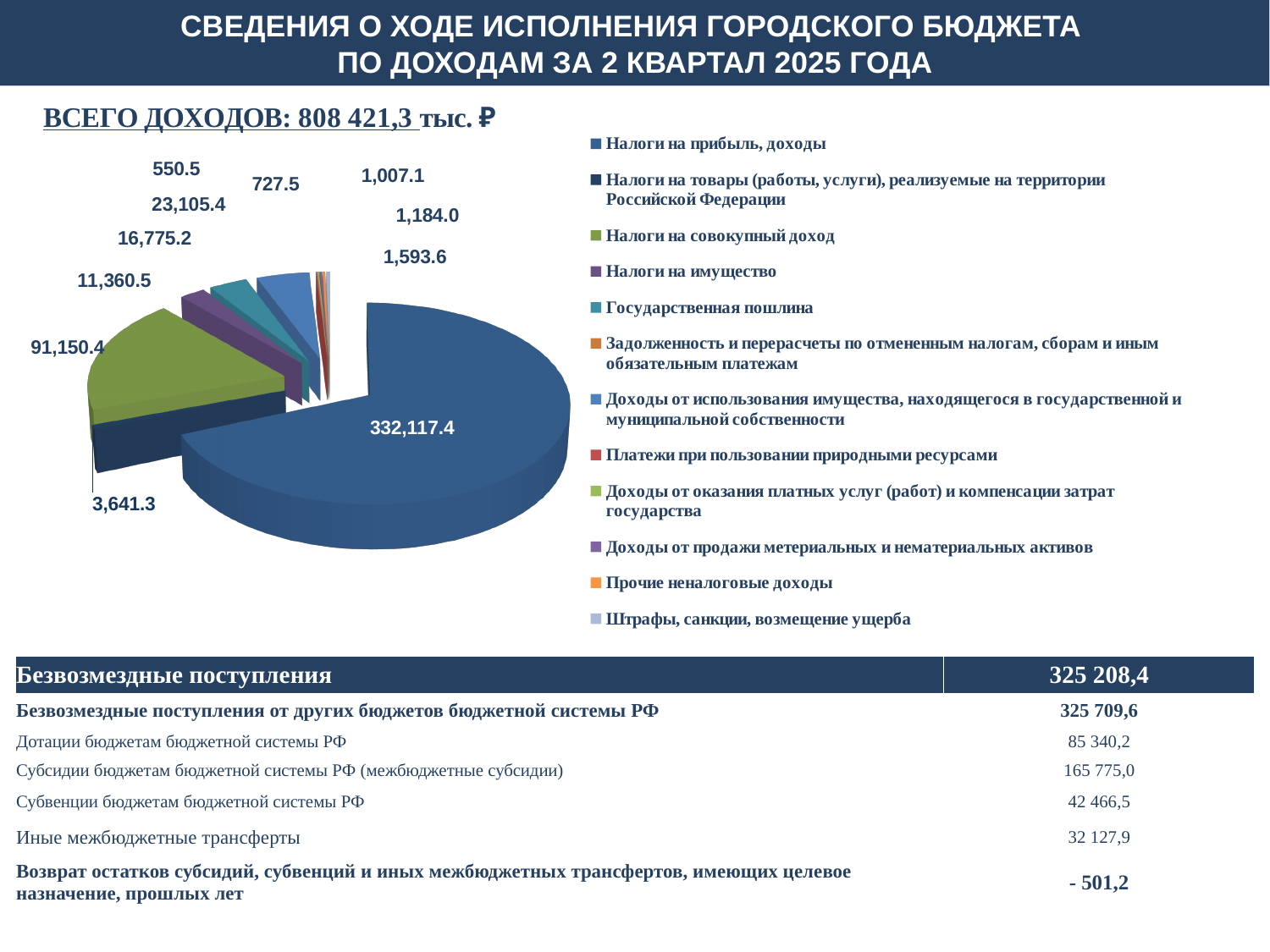
What is the value shown for Доходы от использования имущества, находящегося в государственной и муниципальной собственности? 23,105.4 What is the difference between the values for Налоги на прибыль, доходы and Налоги на совокупный доход? 240,967.0 What is the smallest data label value shown on the pie chart? 550.5 Which is larger: Государственная пошлина or Налоги на имущество? Государственная пошлина What kind of chart is shown on the slide? Pie chart How many entries does the legend of the pie chart list? 12 What is the value shown for Государственная пошлина? 16,775.2 What is the value of the largest slice in the pie chart? 332,117.4 What is the value shown for Налоги на совокупный доход? 91,150.4 What is the value shown for Налоги на имущество? 11,360.5 What total income is stated in the heading above the pie chart? 808 421,3 тыс. ₽ Which category has the largest slice in the pie chart? Налоги на прибыль, доходы